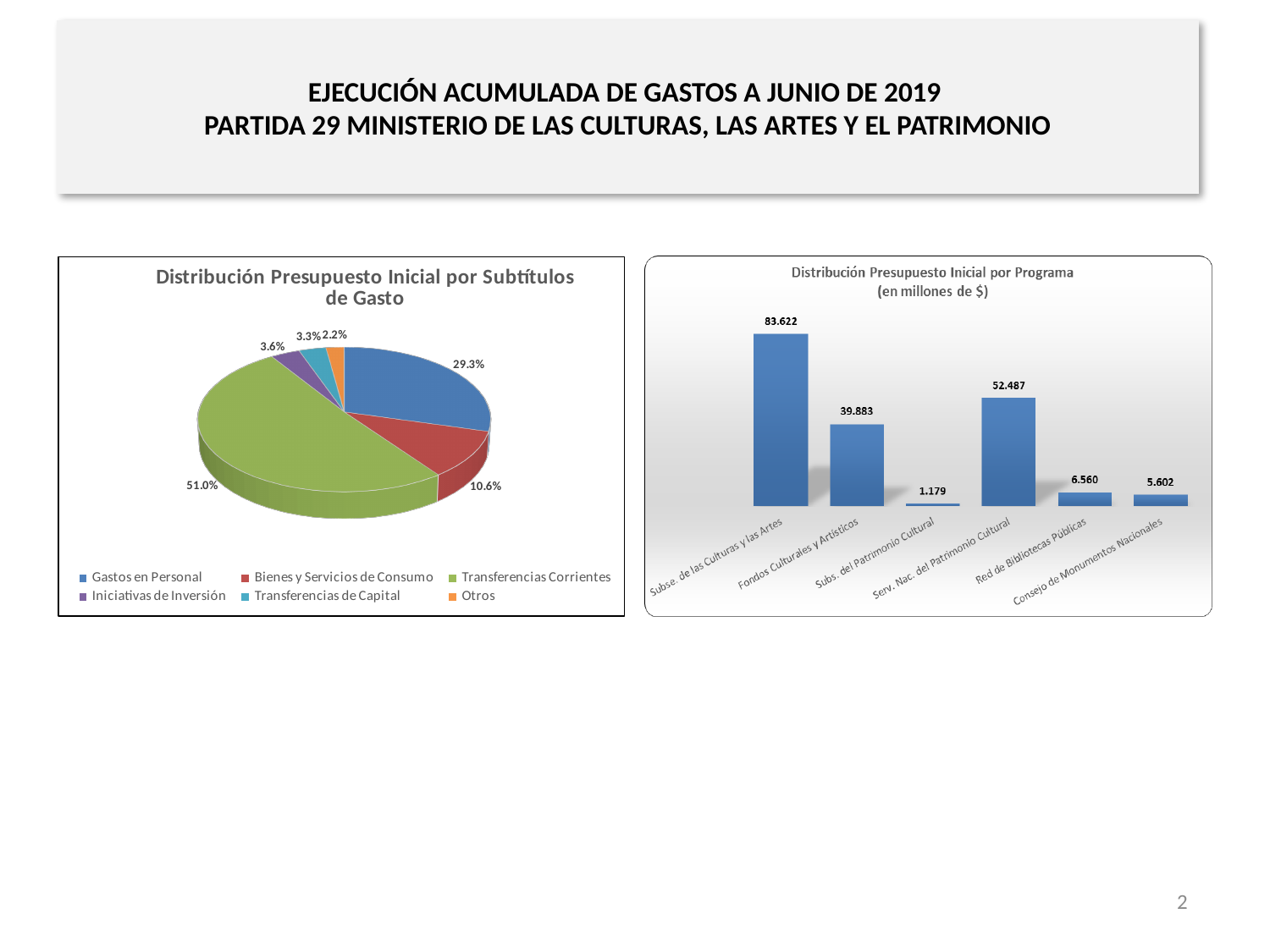
What type of chart is 'Distribución Presupuesto Inicial por Subtítulos de Gasto'? Pie chart In the 'Distribución Presupuesto Inicial por Programa' chart, what is the difference between Subse. de las Culturas y las Artes and Fondos Culturales y Artísticos? 43.739 In the 'Distribución Presupuesto Inicial por Subtítulos de Gasto' chart, what share of the pie is Transferencias Corrientes? 51.0% In the 'Distribución Presupuesto Inicial por Programa' chart, which program has the highest value? Subse. de las Culturas y las Artes In the 'Distribución Presupuesto Inicial por Subtítulos de Gasto' chart, which category has the smallest slice? Otros In the 'Distribución Presupuesto Inicial por Programa' chart, which program has the lowest value? Subs. del Patrimonio Cultural In the 'Distribución Presupuesto Inicial por Programa' chart, what is the value for Serv. Nac. del Patrimonio Cultural? 52.487 In the 'Distribución Presupuesto Inicial por Programa' chart, which is larger: Red de Bibliotecas Públicas or Consejo de Monumentos Nacionales? Red de Bibliotecas Públicas In the 'Distribución Presupuesto Inicial por Subtítulos de Gasto' chart, what percentage is shown for Gastos en Personal? 29.3% In the 'Distribución Presupuesto Inicial por Subtítulos de Gasto' chart, how many categories does the legend list? 6 In the 'Distribución Presupuesto Inicial por Subtítulos de Gasto' chart, what is the difference in percentage points between Gastos en Personal and Bienes y Servicios de Consumo? 18.7 What type of chart is 'Distribución Presupuesto Inicial por Programa'? Bar chart